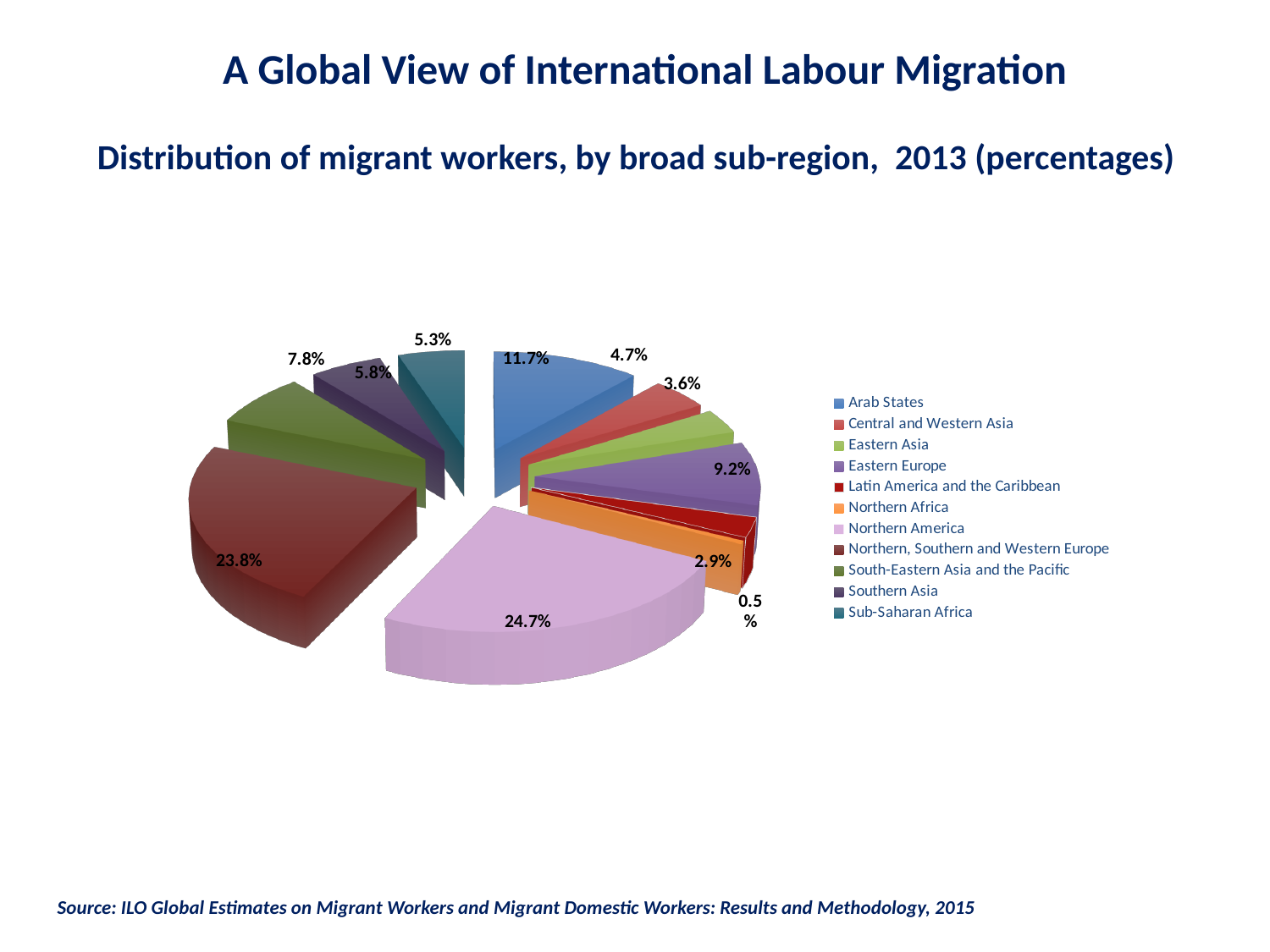
Which has a larger share of migrant workers, Eastern Europe or South-Eastern Asia and the Pacific? Eastern Europe What share of migrant workers is in Sub-Saharan Africa? 5.3% What share of migrant workers is in Arab States? 11.7% Which sub-region has the smallest share of migrant workers? Northern Africa What share of migrant workers is in Northern America? 24.7% What kind of chart is shown on the slide? Pie chart How many sub-regions are listed in the legend? 11 What is the difference in percentage points between Northern America and Northern, Southern and Western Europe? 0.9 What share of migrant workers is in Eastern Europe? 9.2% What share of migrant workers is in Latin America and the Caribbean? 2.9% What is the subtitle of the chart? Distribution of migrant workers, by broad sub-region, 2013 (percentages) Which sub-region has the largest share of migrant workers? Northern America